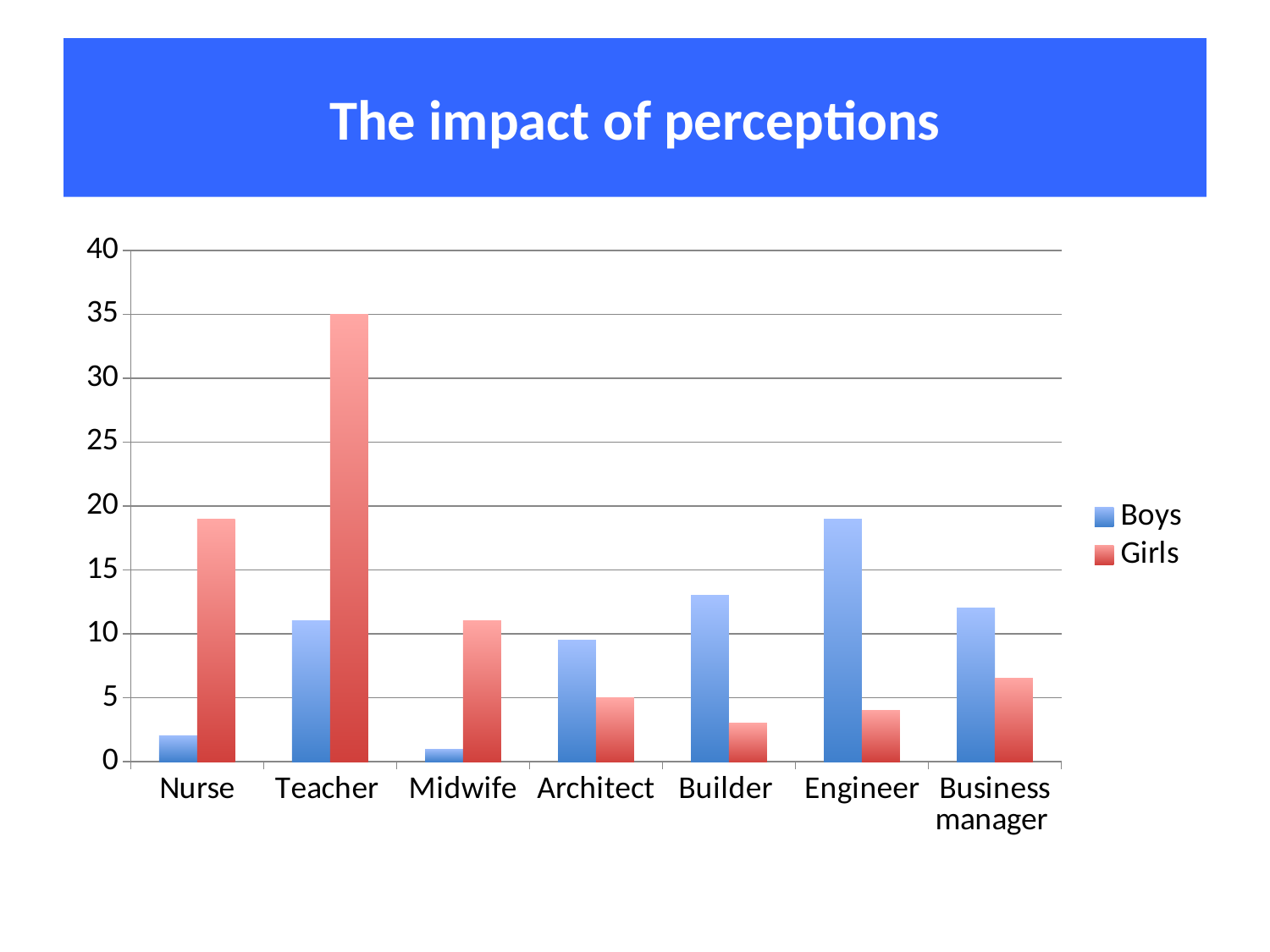
What kind of chart is shown on the slide? bar chart For Nurse, which series has the larger value, Boys or Girls? Girls Which occupation has the highest Girls value? Teacher For Engineer, which series has the larger value, Boys or Girls? Boys What is the title of the slide containing the chart? The impact of perceptions Which occupation has the highest Boys value? Engineer What is the Girls value for Teacher? 35 How many occupation categories are shown on the x axis? 7 Is the Girls value for Nurse greater or less than 15? greater Is the Boys value for Builder greater or less than 15? less Which occupation has the lowest Boys value? Midwife How many series does the legend list? 2